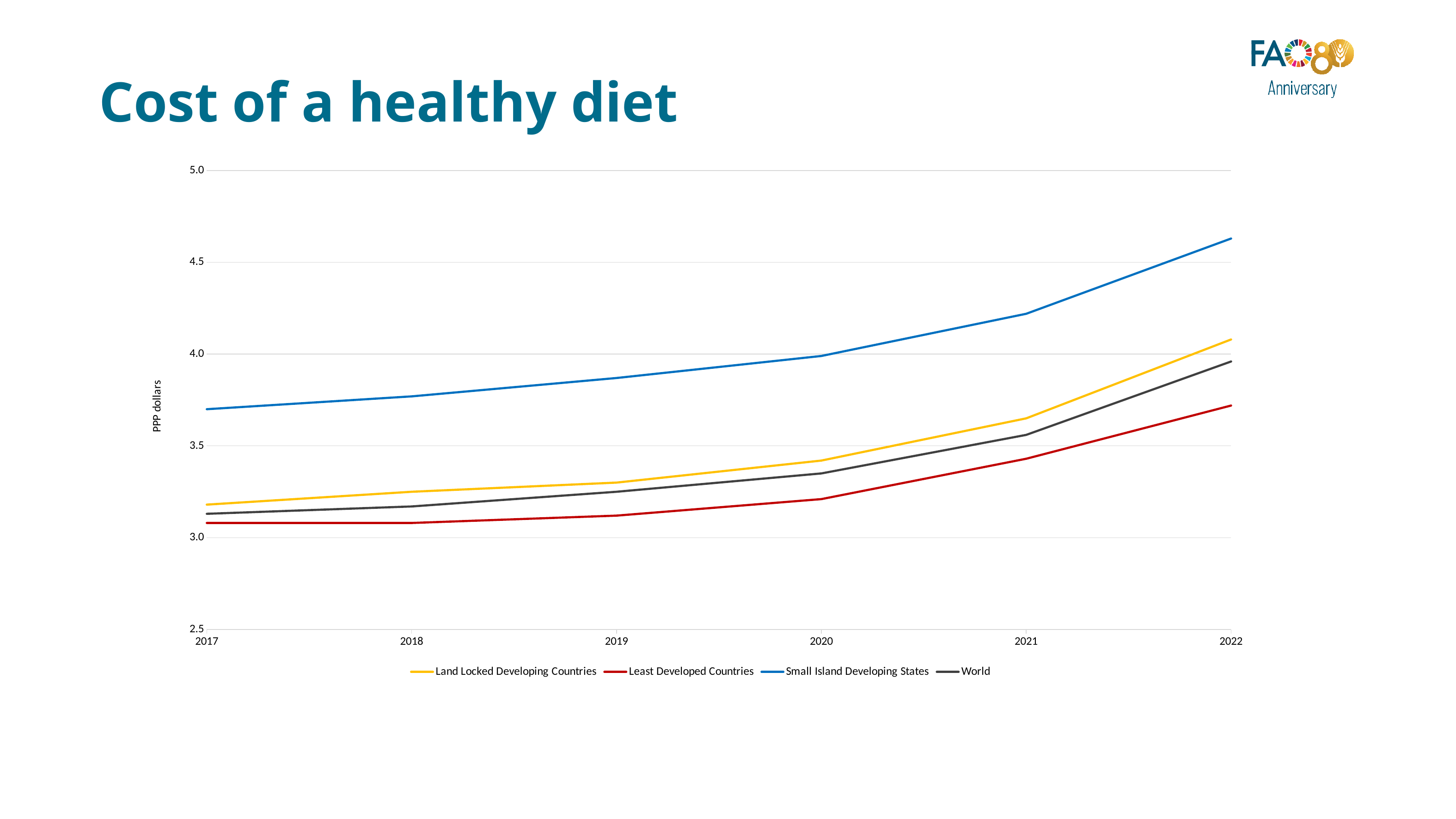
Is the value for Small Island Developing States in 2022 greater or less than 4.5? greater How many series does the legend list? 4 Is the value for Least Developed Countries in 2017 greater or less than 3.5? less What is the title of the slide? Cost of a healthy diet How many years are shown along the x axis? 6 What kind of chart is shown on the slide? line chart In 2021, which is larger: the value for Land Locked Developing Countries or the value for World? Land Locked Developing Countries Does the Small Island Developing States line rise or fall from 2017 to 2022? rise Is the value for Land Locked Developing Countries in 2022 greater or less than 4.0? greater Which series has the lowest value in 2022? Least Developed Countries Which series has the highest value in 2022? Small Island Developing States What is the label on the y axis? PPP dollars